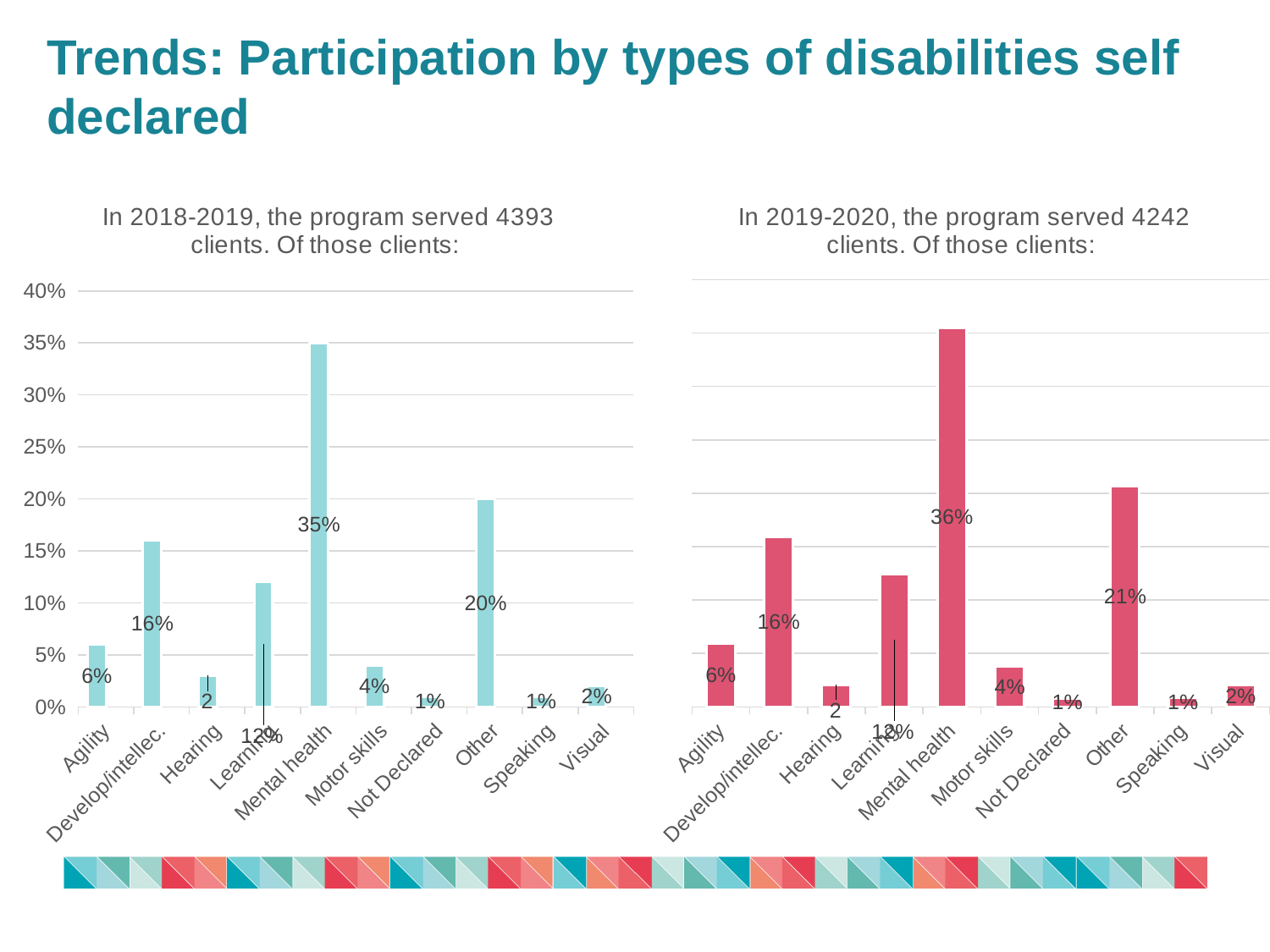
In the 2019-2020 chart, what percentage of clients declared a mental health disability? 36% In the 2018-2019 chart, is the value for Mental health greater or less than 30%? greater In the 2018-2019 chart, what is the value for Develop/intellec.? 16% According to the 2019-2020 chart's title, how many clients did the program serve in 2019-2020? 4242 In the 2018-2019 chart, what percentage of clients declared a mental health disability? 35% In the 2018-2019 chart, which category has the highest value? Mental health In the 2019-2020 chart, which is larger, the value for Other or the value for Develop/intellec.? Other What type of chart is the 2019-2020 chart? bar chart How many categories are shown on the x axis of the 2018-2019 chart? 10 In the 2019-2020 chart, which category has the highest value? Mental health In the 2018-2019 chart, what is the difference between the values for Mental health and Other? 15% In the 2019-2020 chart, what is the value for Other? 21%